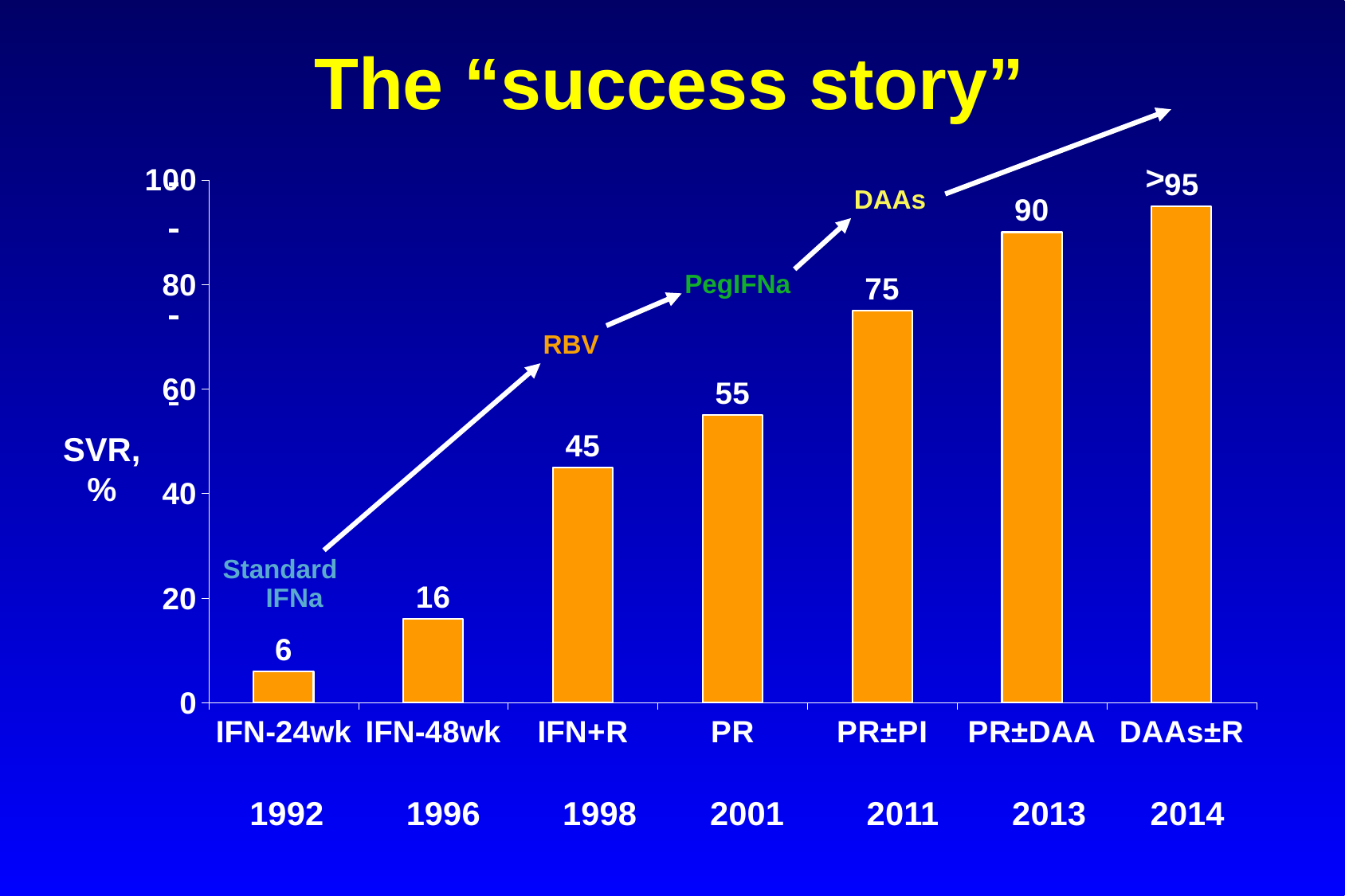
Which category has the lowest SVR value? IFN-24wk What is the data label shown for DAAs±R? >95 How many bars are shown in the chart? 7 What is the difference between the SVR values for IFN-48wk and IFN-24wk? 10 What is the SVR value for PR±PI? 75 What is the SVR value for IFN-24wk? 6 Do the SVR values rise or fall from left to right along the x axis? Rise What type of chart is shown on the slide? Bar chart Which has a higher SVR value, PR or IFN+R? PR Which category has the highest SVR value? DAAs±R What is the difference between the SVR values for PR±DAA and PR? 35 What is the SVR value for IFN+R? 45